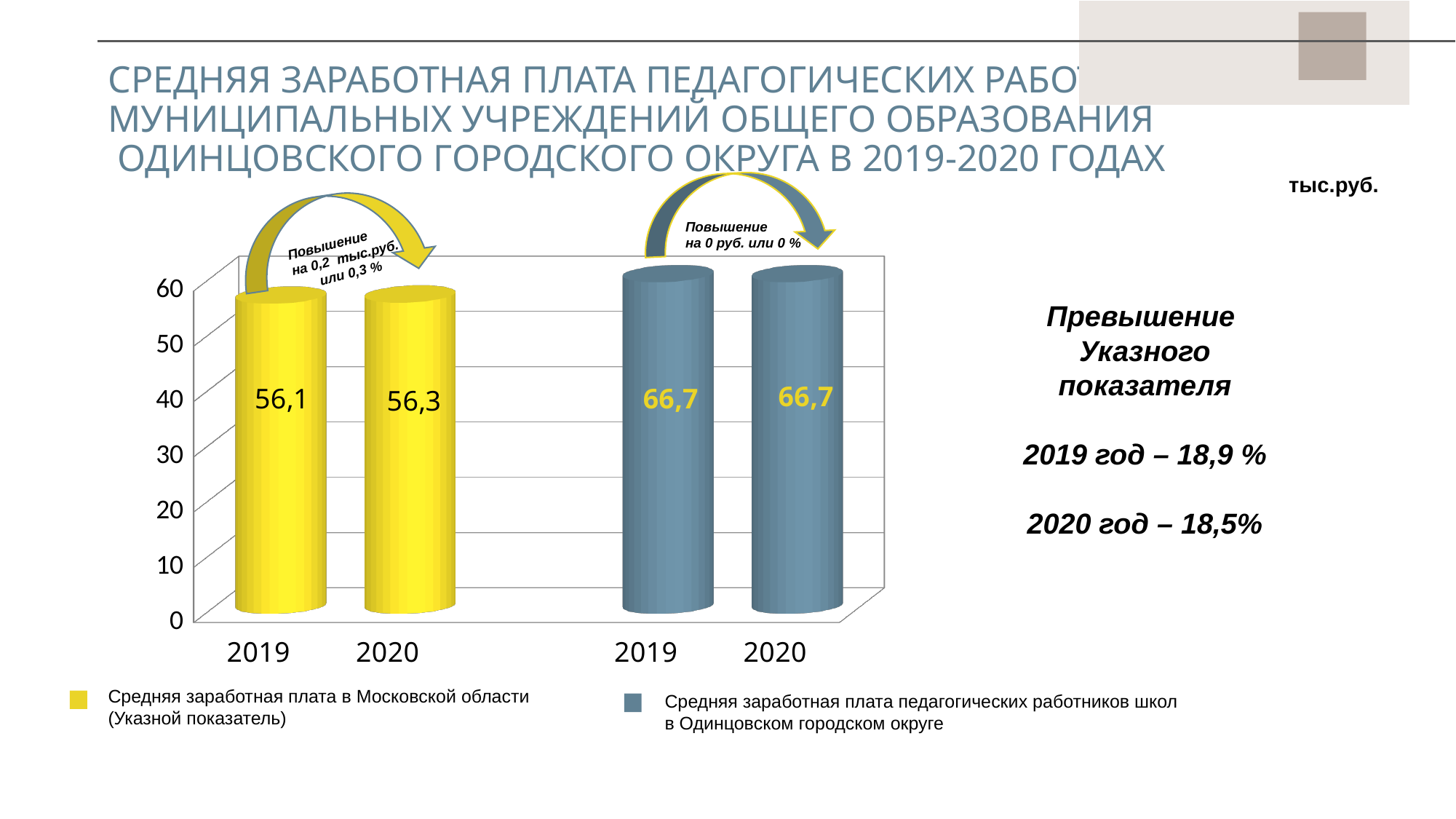
Is the value for the Odintsovo teachers' salary in 2019 greater or less than 60? greater What is the average salary of school teachers in the Odintsovo urban district for 2020? 66,7 Which bar shows the lowest value on the chart? Moscow region (Указной показатель) 2019, 56,1 What is the average salary in the Moscow region (Указной показатель) for 2020? 56,3 How many bars are plotted on the chart? 4 What type of chart is shown on the slide? Bar chart How many series does the legend list? 2 Which is larger in 2019: the Moscow region indicator or the Odintsovo teachers' salary? Odintsovo teachers' salary What is the difference between the Moscow region indicator in 2020 and in 2019? 0,2 What is the average salary in the Moscow region (Указной показатель) for 2019? 56,1 What is the difference between the Odintsovo teachers' salary and the Moscow region indicator in 2020? 10,4 What is the average salary of school teachers in the Odintsovo urban district for 2019? 66,7